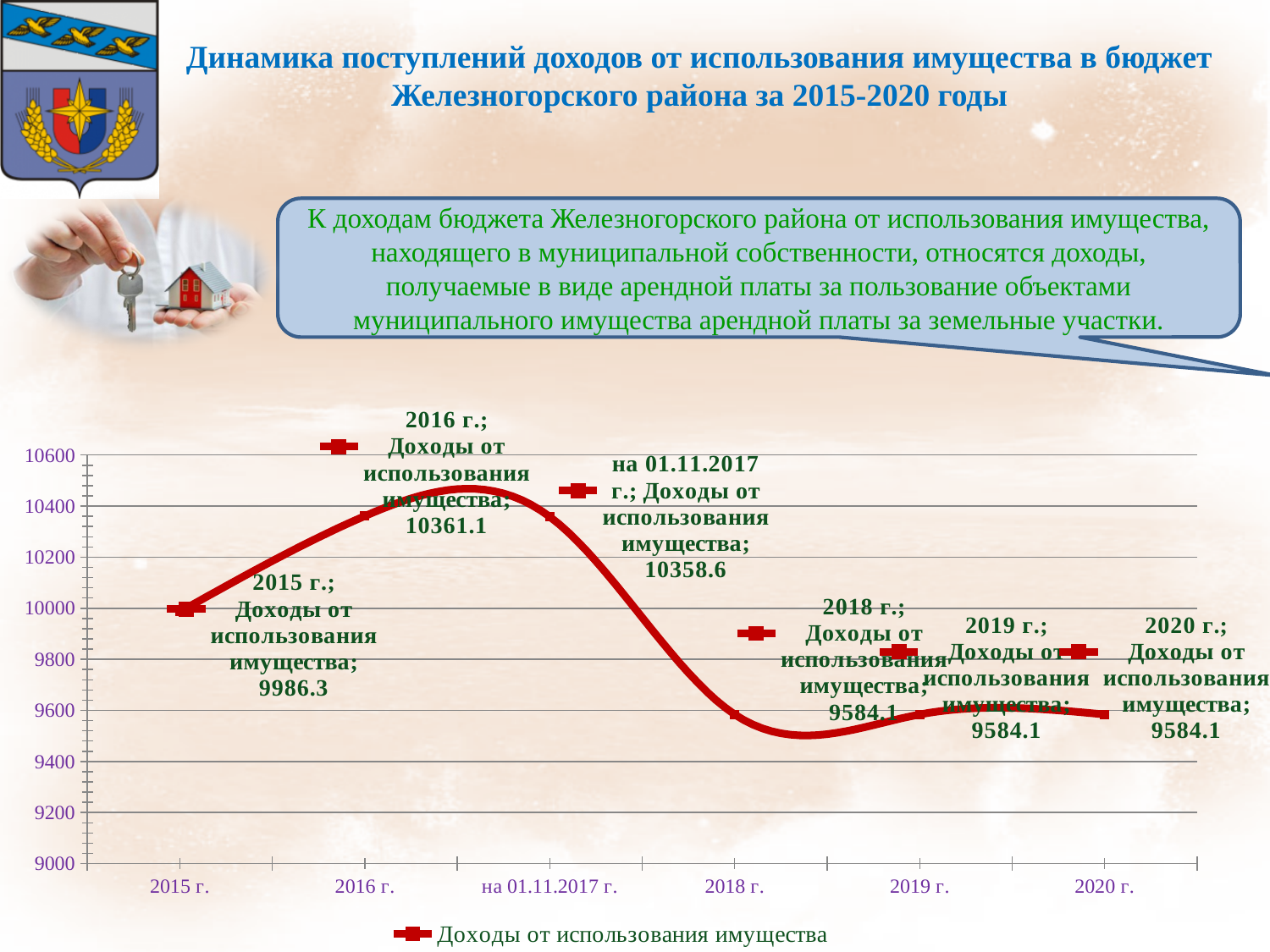
What is the value for 2015 г. in the chart? 9986.3 What is the difference between the values for 2015 г. and 2018 г.? 402.2 Do the values rise or fall from 2016 г. to 2018 г.? fall What kind of chart is shown on the slide? line chart What is the value for на 01.11.2017 г. in the chart? 10358.6 Which year has the highest value in the chart? 2016 г. How many categories are shown on the x axis of the chart? 6 What is the value for 2016 г. in the chart? 10361.1 Is the value for 2018 г. greater or less than 9800? less What is the value for 2020 г. in the chart? 9584.1 Which is larger, the value for 2015 г. or the value for 2019 г.? 2015 г. What is the difference between the values for 2016 г. and 2015 г.? 374.8